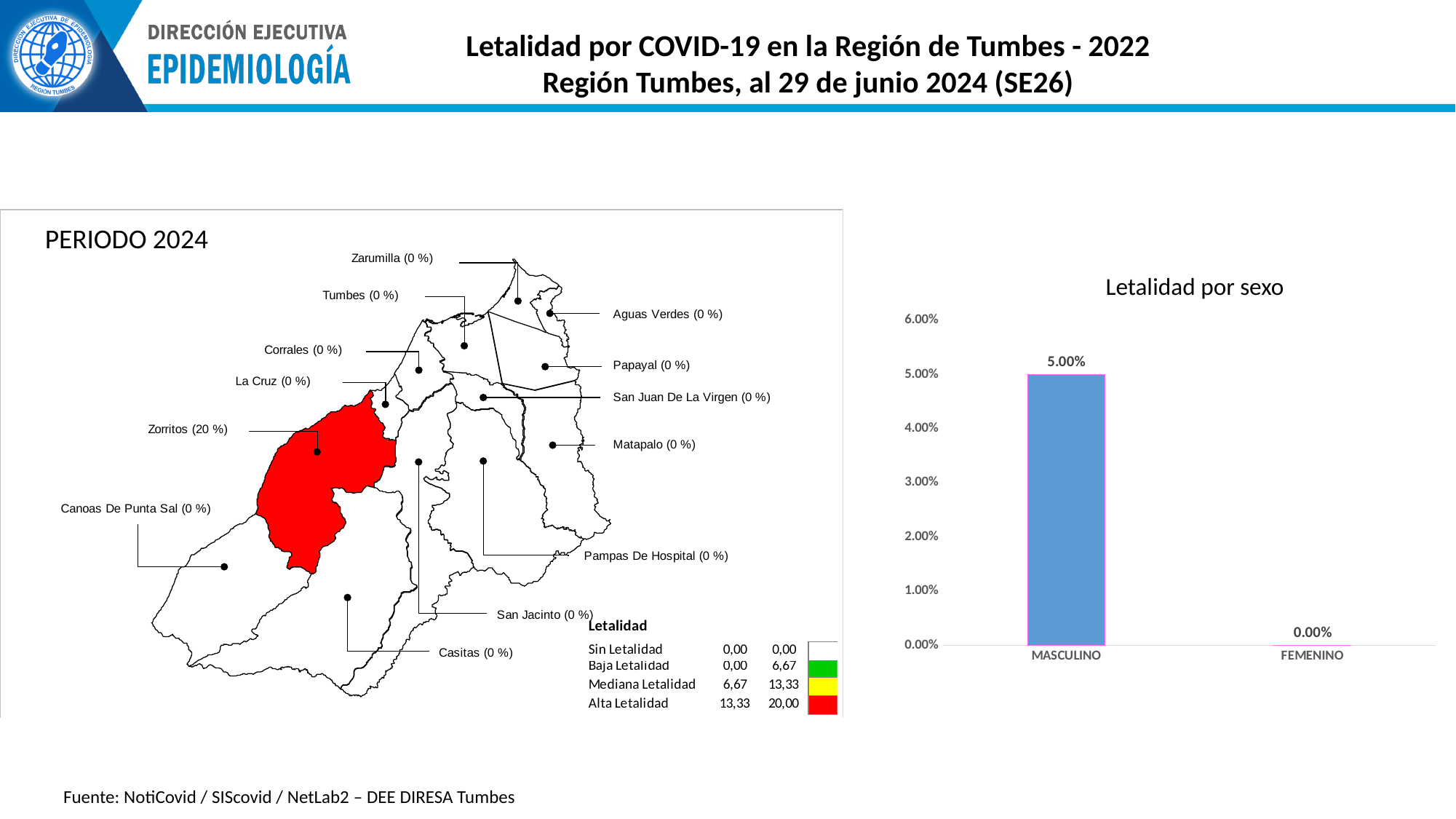
On the map 'PERIODO 2024', what is the lethality value shown for Zorritos? 20 % In the 'Letalidad por sexo' chart, what is the value for MASCULINO? 5.00% What kind of chart is 'Letalidad por sexo'? bar chart In the 'Letalidad por sexo' chart, what is the value for FEMENINO? 0.00% What is the highest value shown on the y axis of the 'Letalidad por sexo' chart? 6.00% In the 'Letalidad por sexo' chart, is the value for MASCULINO greater or less than 4.00%? greater On the map 'PERIODO 2024', which district has the highest lethality value? Zorritos In the 'Letalidad por sexo' chart, which category has the highest value? MASCULINO In the 'Letalidad por sexo' chart, which category has the lowest value? FEMENINO In the 'Letalidad por sexo' chart, what is the difference between the MASCULINO and FEMENINO values? 5.00% On the map 'PERIODO 2024', what lethality category does the red colour represent in the legend? Alta Letalidad How many categories are shown in the 'Letalidad por sexo' chart? 2